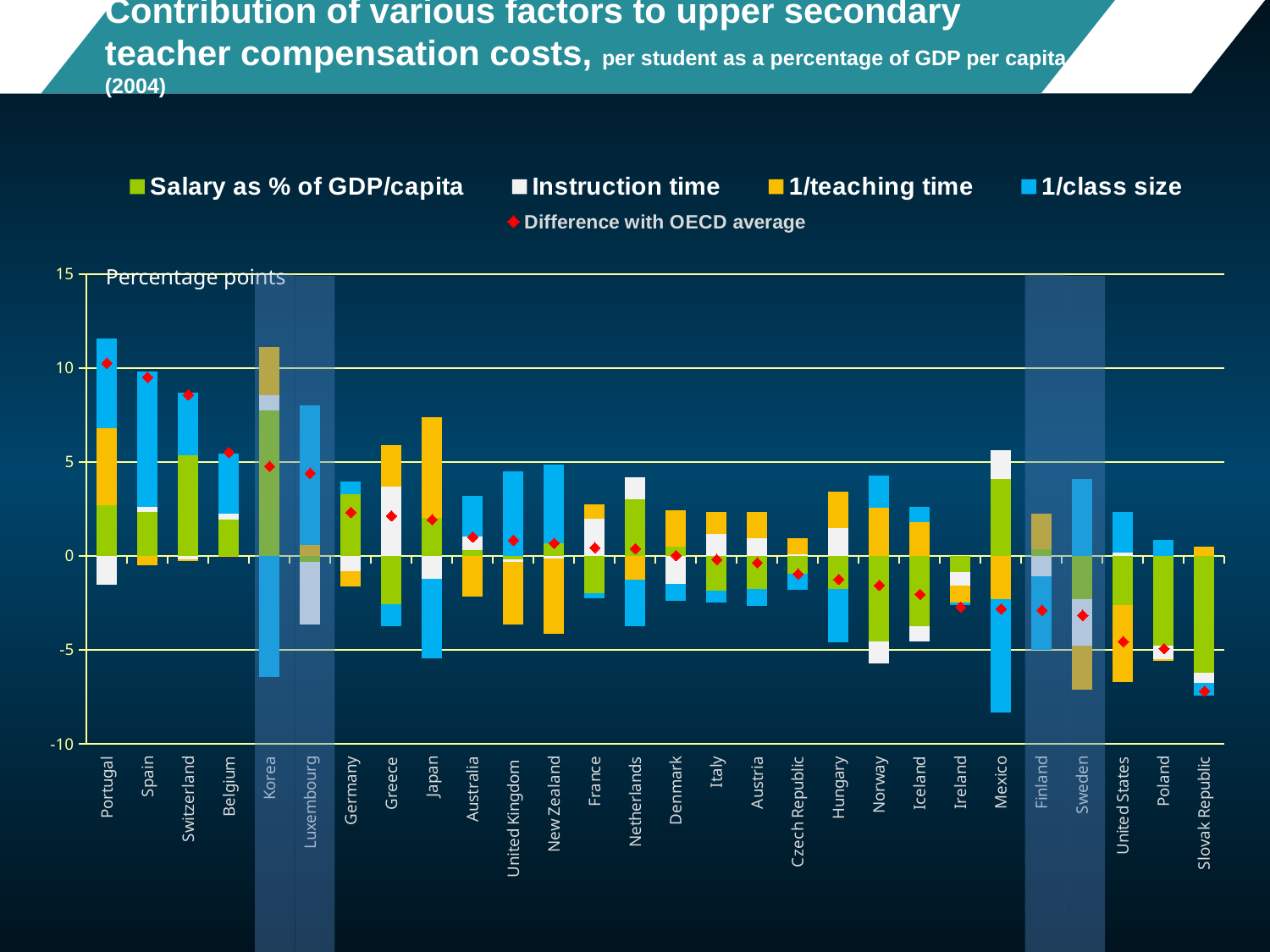
Which country has the highest 'Difference with OECD average' marker? Portugal Is the 'Difference with OECD average' value for Slovak Republic greater or less than -5? less What unit label is shown at the top of the y axis? Percentage points Is the 'Difference with OECD average' value for Spain greater or less than 10? less Which has the larger 'Difference with OECD average' value, Spain or Germany? Spain How many countries are shown along the x axis of the chart? 28 What kind of chart is shown on the slide? bar chart Is the 'Difference with OECD average' value for Mexico greater or less than 0? less How many entries does the chart's legend list? 5 Which country has the lowest 'Difference with OECD average' marker? Slovak Republic Do the 'Difference with OECD average' markers generally rise or fall from left to right along the x axis? fall